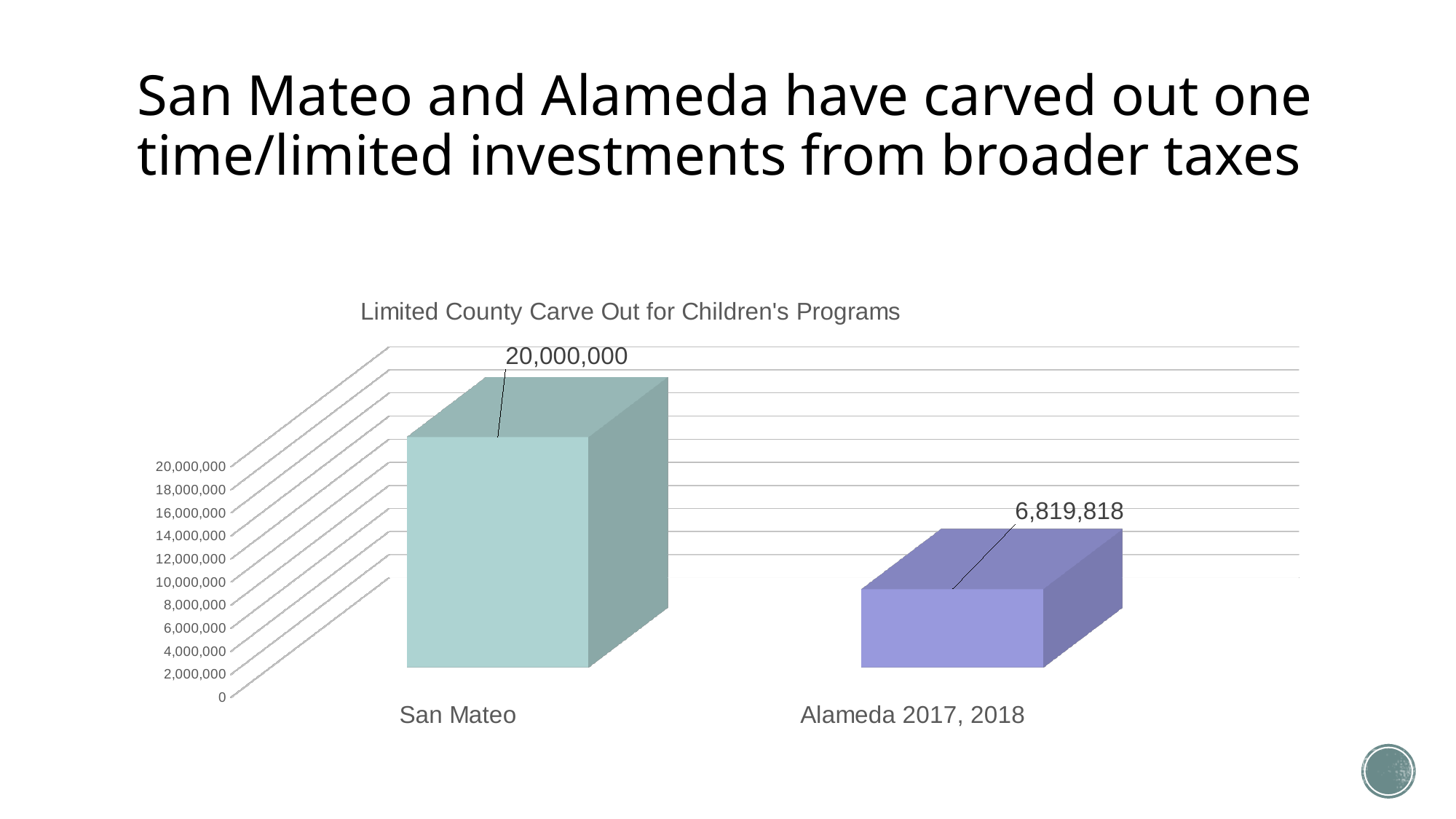
Is the value for Alameda 2017, 2018 greater or less than 10,000,000? less What kind of chart is shown on the slide? Bar chart Which category has the highest value? San Mateo What is the difference between the values for San Mateo and Alameda 2017, 2018? 13,180,182 Which category has the lowest value? Alameda 2017, 2018 Which is larger, the value for San Mateo or the value for Alameda 2017, 2018? San Mateo What is the title of the chart? Limited County Carve Out for Children's Programs What is the highest value shown on the vertical axis? 20,000,000 How many categories are shown in the chart? 2 Is the value for San Mateo greater or less than 14,000,000? greater What is the value for Alameda 2017, 2018? 6,819,818 What is the value for San Mateo? 20,000,000